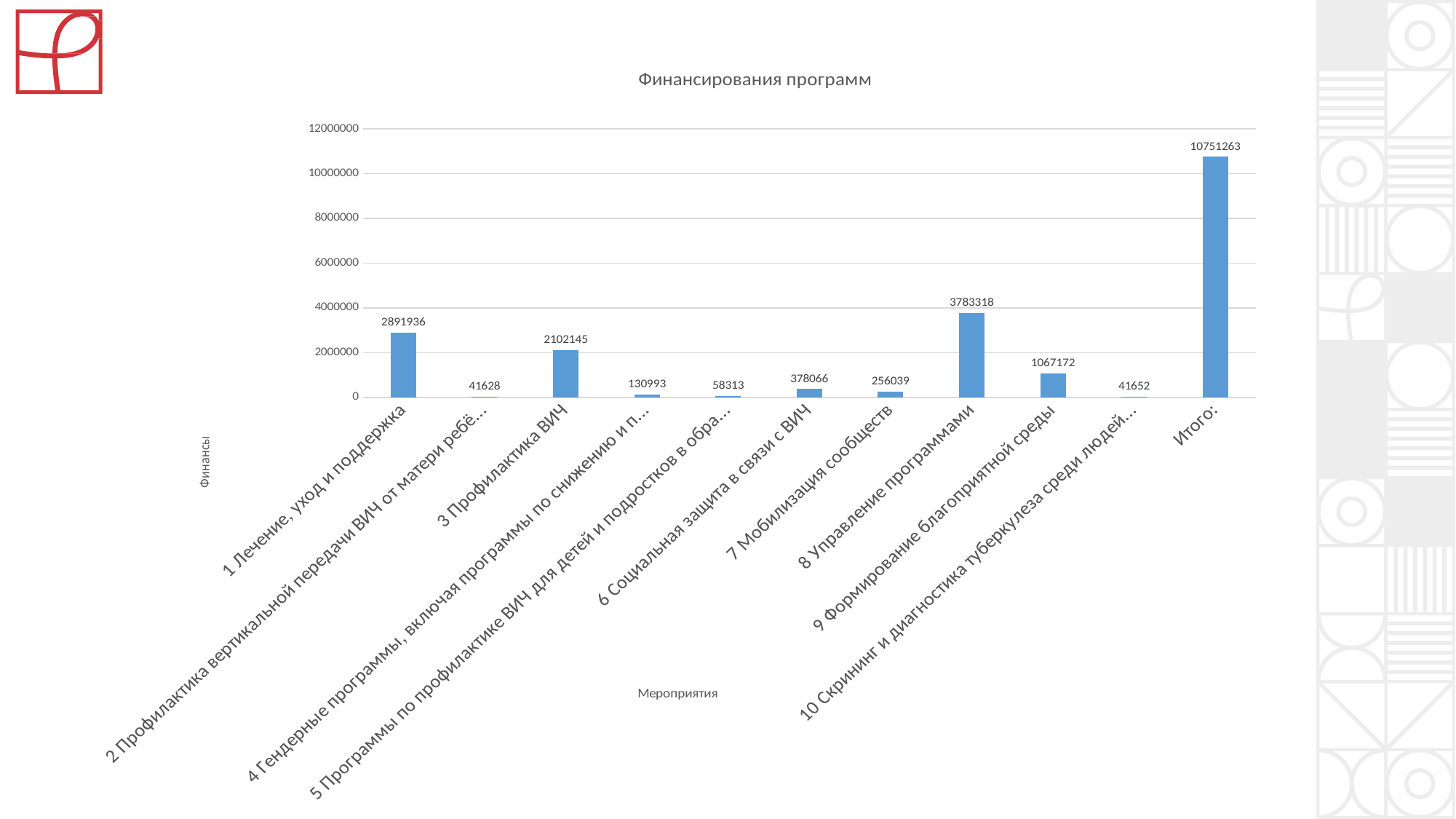
What is the difference between "8 Управление программами" and "1 Лечение, уход и поддержка"? 891382 Excluding "Итого:", which program has the highest value? 8 Управление программами What is the value for "1 Лечение, уход и поддержка"? 2891936 What is the value for "Итого:"? 10751263 Which is larger: "6 Социальная защита в связи с ВИЧ" or "7 Мобилизация сообществ"? 6 Социальная защита в связи с ВИЧ What is the value for "9 Формирование благоприятной среды"? 1067172 Which category has the highest bar? Итого: How many categories are shown on the x axis? 11 Is the value for "Итого:" greater or less than 10000000? greater What is the value for "8 Управление программами"? 3783318 What is the value for "3 Профилактика ВИЧ"? 2102145 What type of chart is this? bar chart